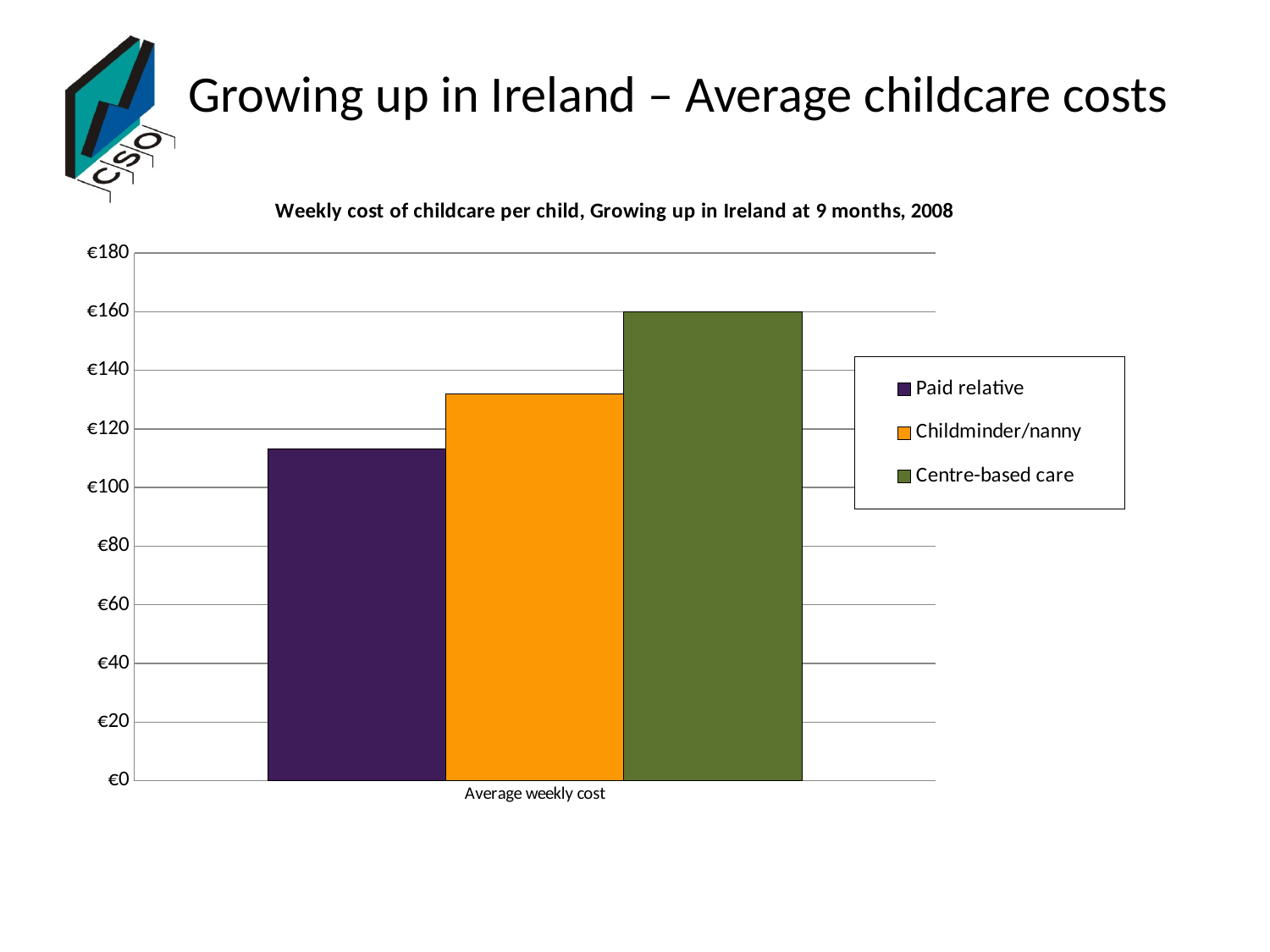
Is the average weekly cost for Centre-based care greater or less than €140? greater Which is larger, the average weekly cost for Childminder/nanny or for Paid relative? Childminder/nanny What colour is the bar for Childminder/nanny? orange Is the average weekly cost for Paid relative greater or less than €120? less Which is larger, the average weekly cost for Centre-based care or for Childminder/nanny? Centre-based care Which series has the highest average weekly cost? Centre-based care What kind of chart is shown on the slide? bar chart How many series does the legend list? 3 What is the title of the chart? Weekly cost of childcare per child, Growing up in Ireland at 9 months, 2008 Is the average weekly cost for Paid relative greater or less than €100? greater Which series has the lowest average weekly cost? Paid relative